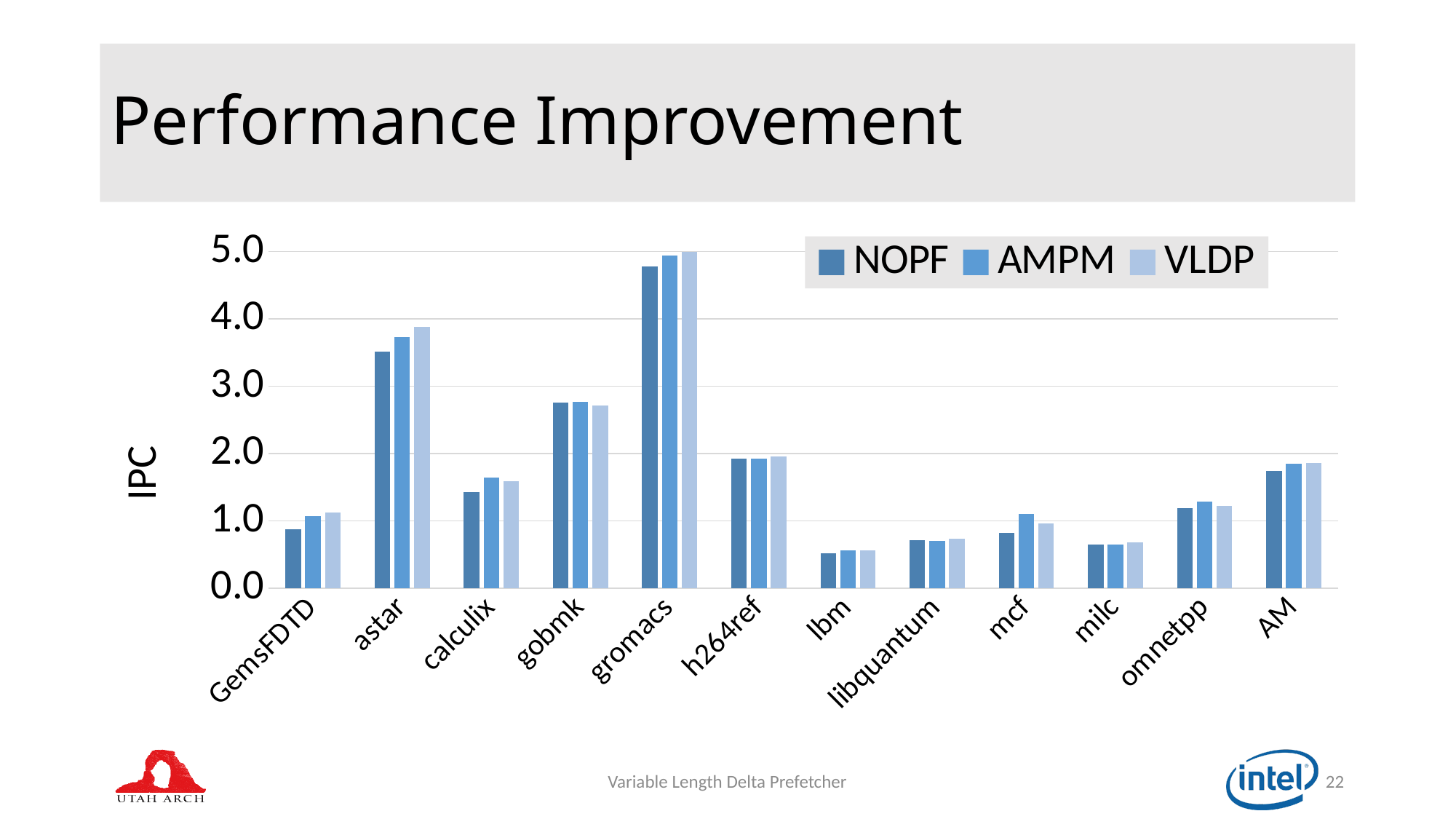
Is the VLDP value for gobmk greater or less than 3.0? less Which category has the highest IPC values? gromacs What kind of chart is shown on the slide? bar chart Is the NOPF value for gromacs greater or less than 4.0? greater For mcf, which is larger: the AMPM value or the VLDP value? AMPM How many benchmark categories are shown on the x axis? 12 How many series does the legend list? 3 For astar, which is larger: the NOPF value or the VLDP value? VLDP Is the NOPF value for astar greater or less than 3.0? greater Which category has the lowest IPC values? lbm